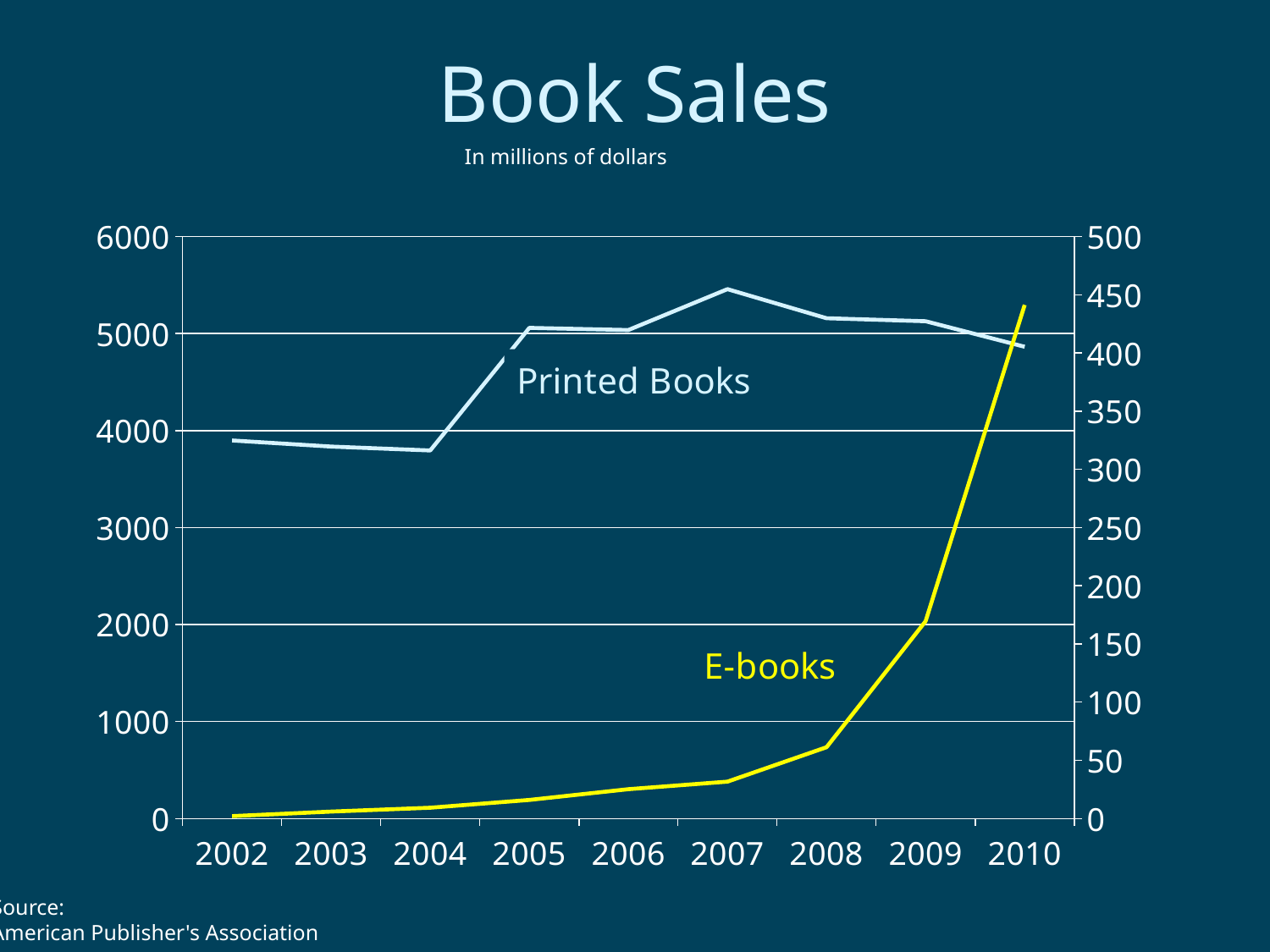
Do E-books sales rise or fall from 2002 to 2010? rise How many years are shown along the x axis? 9 Is the E-books value for 2010 greater or less than 400 on the right axis? greater In which year are E-books sales at their highest? 2010 Do Printed Books sales rise or fall from 2007 to 2010? fall What kind of chart is shown on the slide? line chart Is the Printed Books value for 2007 greater or less than 5000 on the left axis? greater What unit does the subtitle say the sales are measured in? In millions of dollars In which year are E-books sales at their lowest? 2002 Is the Printed Books value for 2004 greater or less than 4000 on the left axis? less How many data series are plotted on the chart? 2 In which year do Printed Books sales reach their highest point? 2007